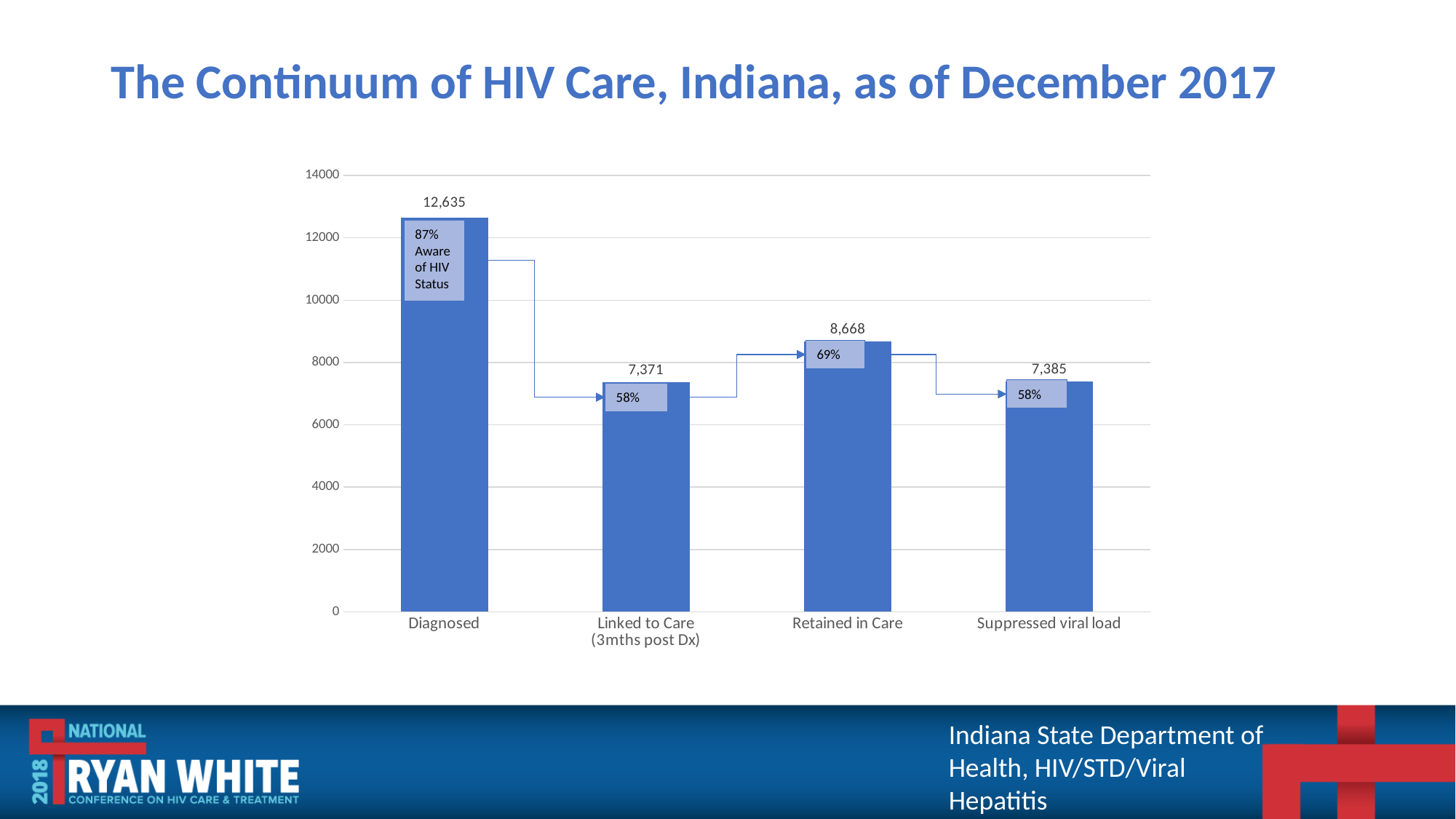
What is the value for Diagnosed? 12,635 How many categories are shown on the x axis? 4 What is the value for Suppressed viral load? 7,385 What is the difference between the Retained in Care value and the Suppressed viral load value? 1,283 Is the value for Retained in Care greater or less than 8000? greater What percentage is shown in the box on the Retained in Care bar? 69% Which is larger, the value for Retained in Care or the value for Linked to Care (3mths post Dx)? Retained in Care What is the difference between the Diagnosed value and the Linked to Care (3mths post Dx) value? 5,264 What is the value for Retained in Care? 8,668 What is the value for Linked to Care (3mths post Dx)? 7,371 What kind of chart is shown on the slide? bar chart Which category has the highest value? Diagnosed